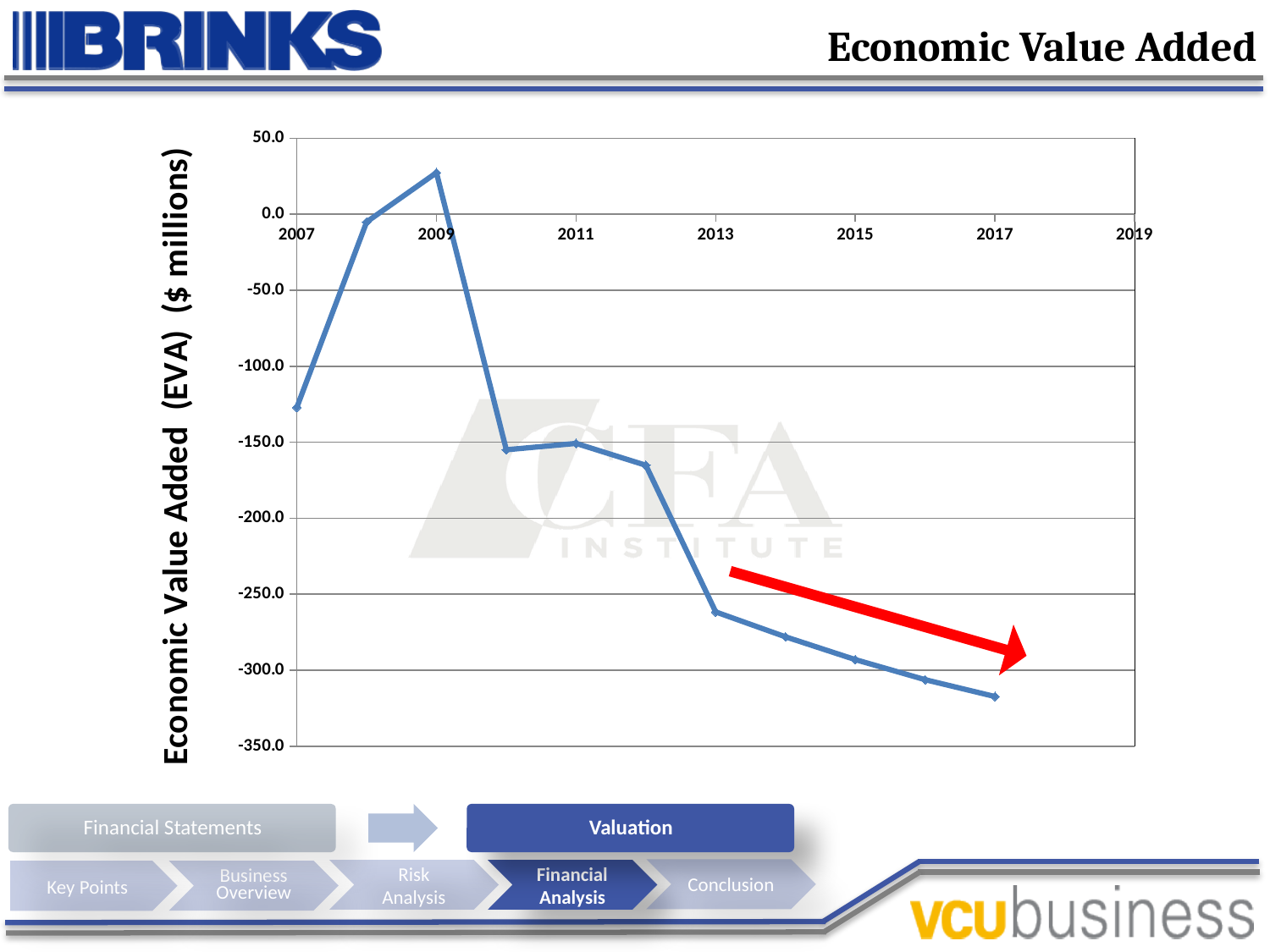
Is the value for 2017 greater or less than -300.0? less Is the value for 2009 greater or less than 0.0? greater Is the value for 2013 greater or less than -250.0? less From 2013 to 2017, does the Economic Value Added rise or fall? fall What kind of chart is shown on the slide? line chart In which year is the Economic Value Added lowest? 2017 How many data points are plotted on the line? 11 What is the label on the vertical axis of the chart? Economic Value Added (EVA) ($ millions) Which year has the larger Economic Value Added, 2011 or 2015? 2011 In which year is the Economic Value Added highest? 2009 What is the title of the chart on the slide? Economic Value Added